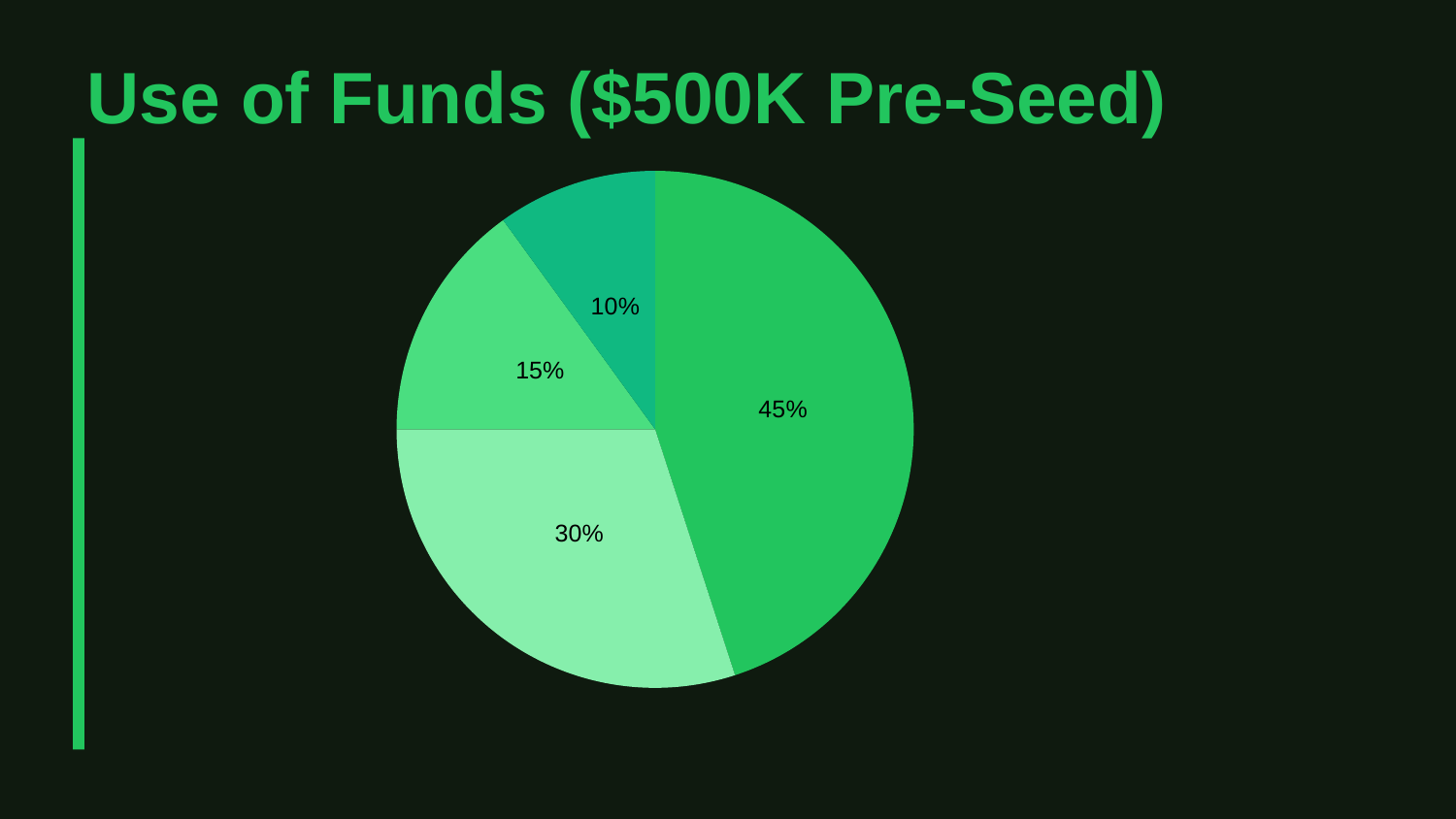
What percentage is shown on the lightest green slice at the bottom left of the pie? 30% Which is larger: the slice on the right side of the pie or the slice at the bottom left? the slice on the right (45%) What kind of chart is shown on the slide? pie chart How many slices does the pie chart have? 4 What is the value of the smallest slice of the pie chart? 10% What is the value of the largest slice of the pie chart? 45% What do the four slice percentages add up to? 100% What percentage is shown on the slice at the top of the pie, just left of the 12 o'clock position? 10% What is the difference in percentage points between the 15% slice and the 10% slice? 5 Does the pie chart include a legend naming the slices? No What is the title of the chart on the slide? Use of Funds ($500K Pre-Seed) What is the difference in percentage points between the largest slice and the second-largest slice? 15